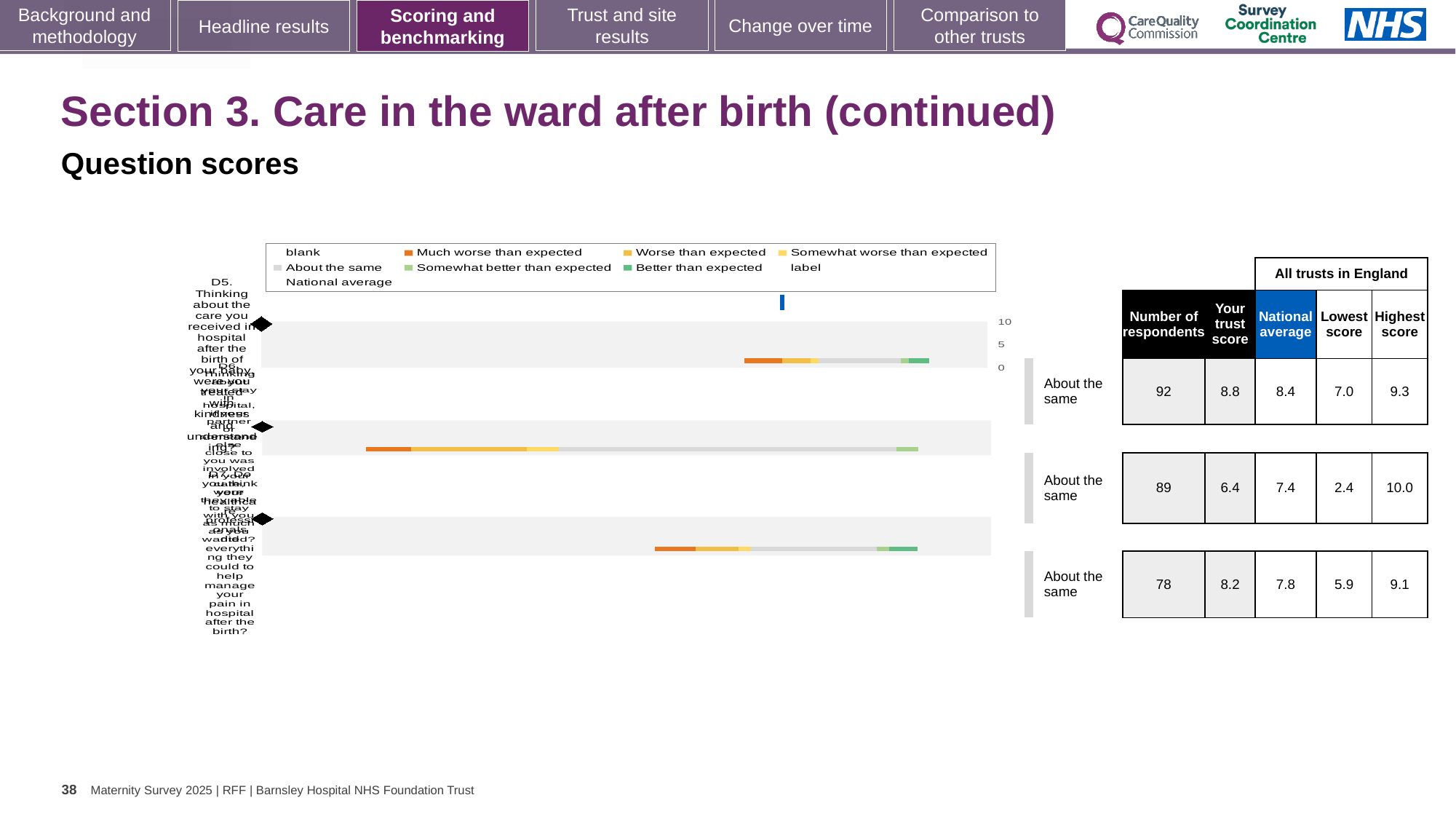
Is the trust score for the second question row larger or smaller than its national average? smaller What is the number of respondents for the first (top) question row? 92 What is the national average for the third (bottom) question row? 7.8 Which question row has the highest trust score? the first row (8.8) What benchmark category is given for each of the three question rows? About the same What is the highest score among all trusts in England for the second question row? 10.0 Which colour represents 'Much worse than expected' in the legend? orange What kind of chart is shown on the slide? bar chart How many question rows (bars) are shown in the chart? 3 Which question row has the lowest 'Lowest score' value? the second row (2.4) What is the difference between the trust score and the national average for the first question row? 0.4 What is the trust score for the second question row? 6.4